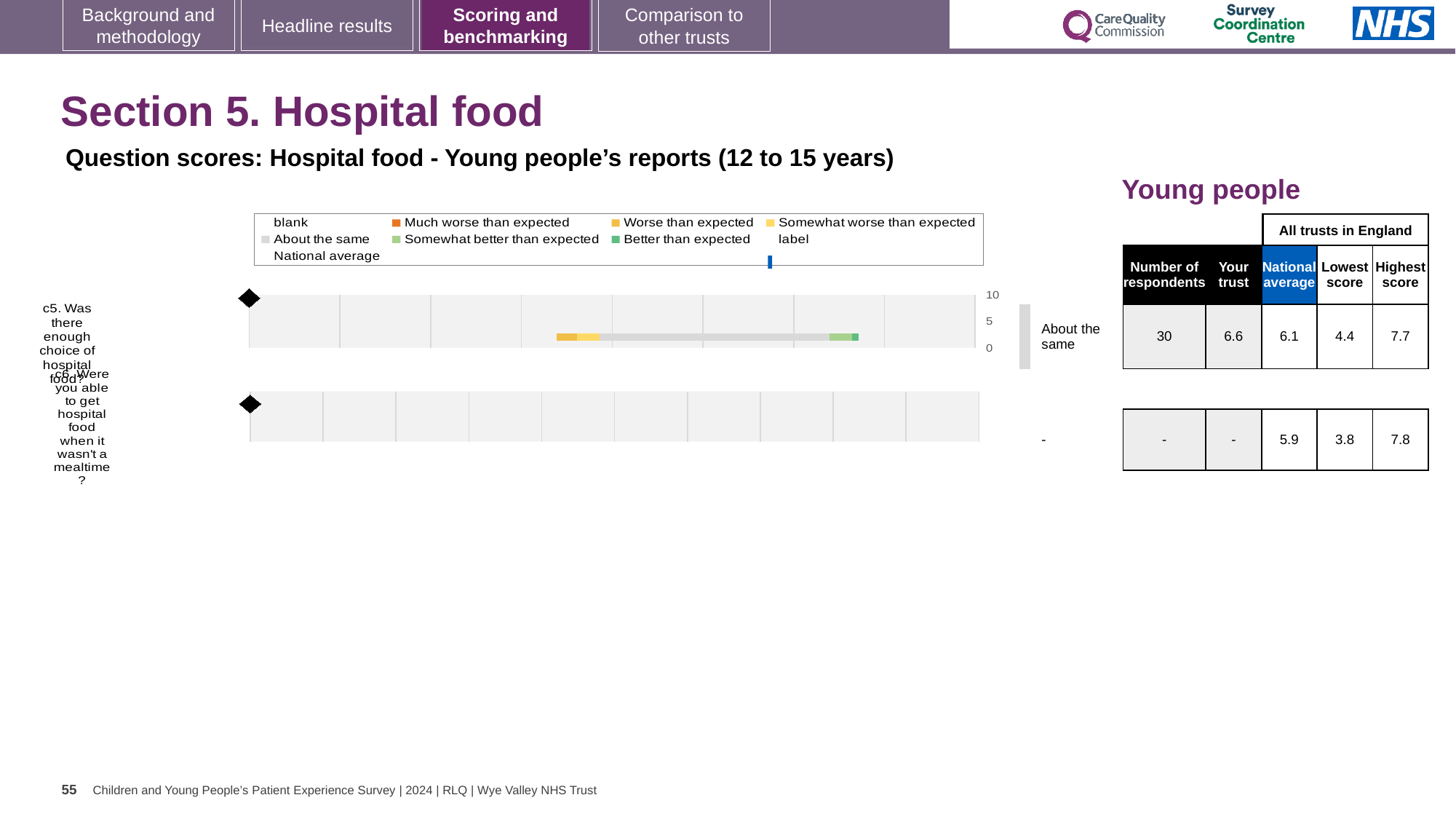
What is the national average score for question c5 (Was there enough choice of hospital food?)? 6.1 What benchmark category is shown for question c5 (Was there enough choice of hospital food?)? About the same What is the difference between the highest and lowest scores across all trusts in England for question c5? 3.3 What type of chart is used to show the question scores for hospital food? bar chart What is the 'Your trust' score for question c5 (Was there enough choice of hospital food?)? 6.6 How many respondents answered question c5 (Was there enough choice of hospital food?)? 30 What is the lowest score across all trusts in England for question c6 (Were you able to get hospital food when it wasn't a mealtime?)? 3.8 How many questions are plotted in the hospital food chart? 2 What is the highest score across all trusts in England for question c5? 7.7 What is the national average score for question c6 (Were you able to get hospital food when it wasn't a mealtime?)? 5.9 Which is larger for question c5: the trust's score or the national average? the trust's score What is the maximum value shown on the chart's score axis? 10